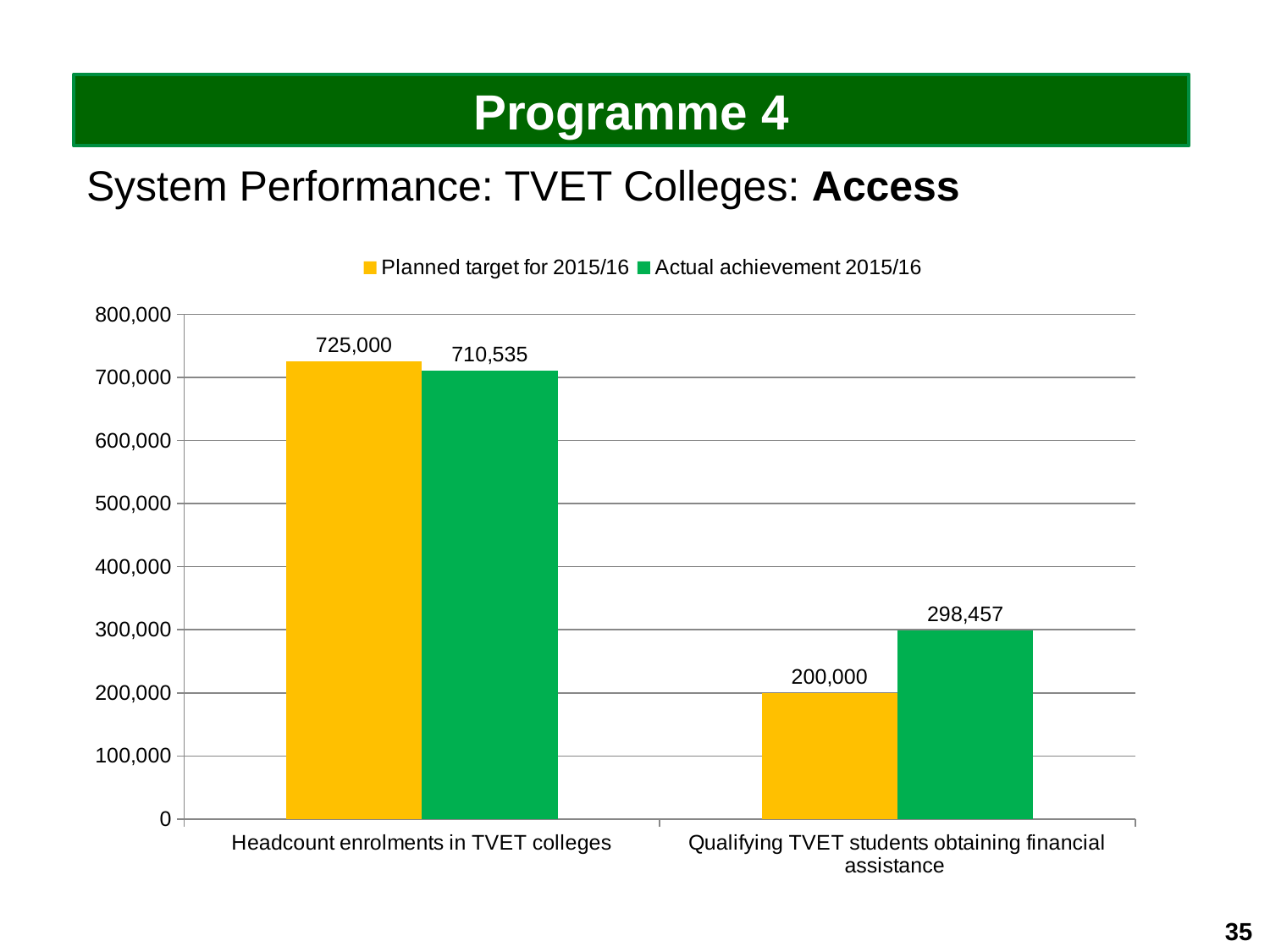
Which category has the lowest actual achievement in 2015/16? Qualifying TVET students obtaining financial assistance What was the actual achievement in 2015/16 for qualifying TVET students obtaining financial assistance? 298,457 What was the actual achievement in 2015/16 for headcount enrolments in TVET colleges? 710,535 By how much did the actual achievement exceed the planned target for qualifying TVET students obtaining financial assistance? 98,457 For headcount enrolments in TVET colleges, which is larger: the planned target or the actual achievement? Planned target By how much did the actual achievement fall short of the planned target for headcount enrolments in TVET colleges? 14,465 How many categories are shown on the x axis of the chart? 2 What was the planned target for 2015/16 for qualifying TVET students obtaining financial assistance? 200,000 What was the planned target for 2015/16 for headcount enrolments in TVET colleges? 725,000 How many series does the legend list? 2 Which category has the highest planned target for 2015/16? Headcount enrolments in TVET colleges What kind of chart is shown on the slide? Bar chart